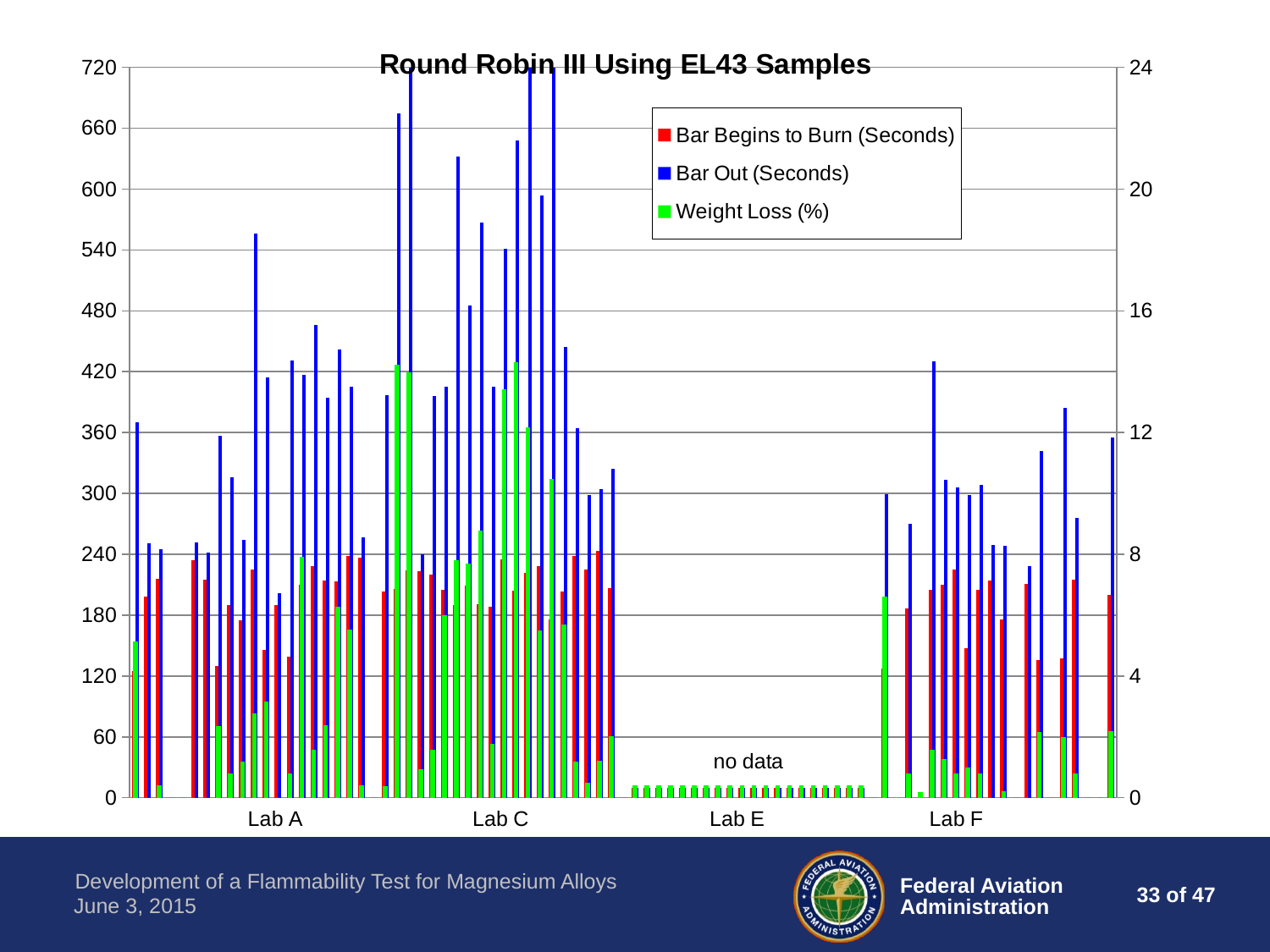
What kind of chart is shown on the slide? bar chart Which lab is marked with the annotation "no data"? Lab E What is the maximum value shown on the right vertical axis? 24 How many lab labels appear along the x axis? 4 What is the title of the chart? Round Robin III Using EL43 Samples What is the maximum value shown on the left vertical axis? 720 How many series does the legend list? 3 Which series is shown in green in the legend? Weight Loss (%)